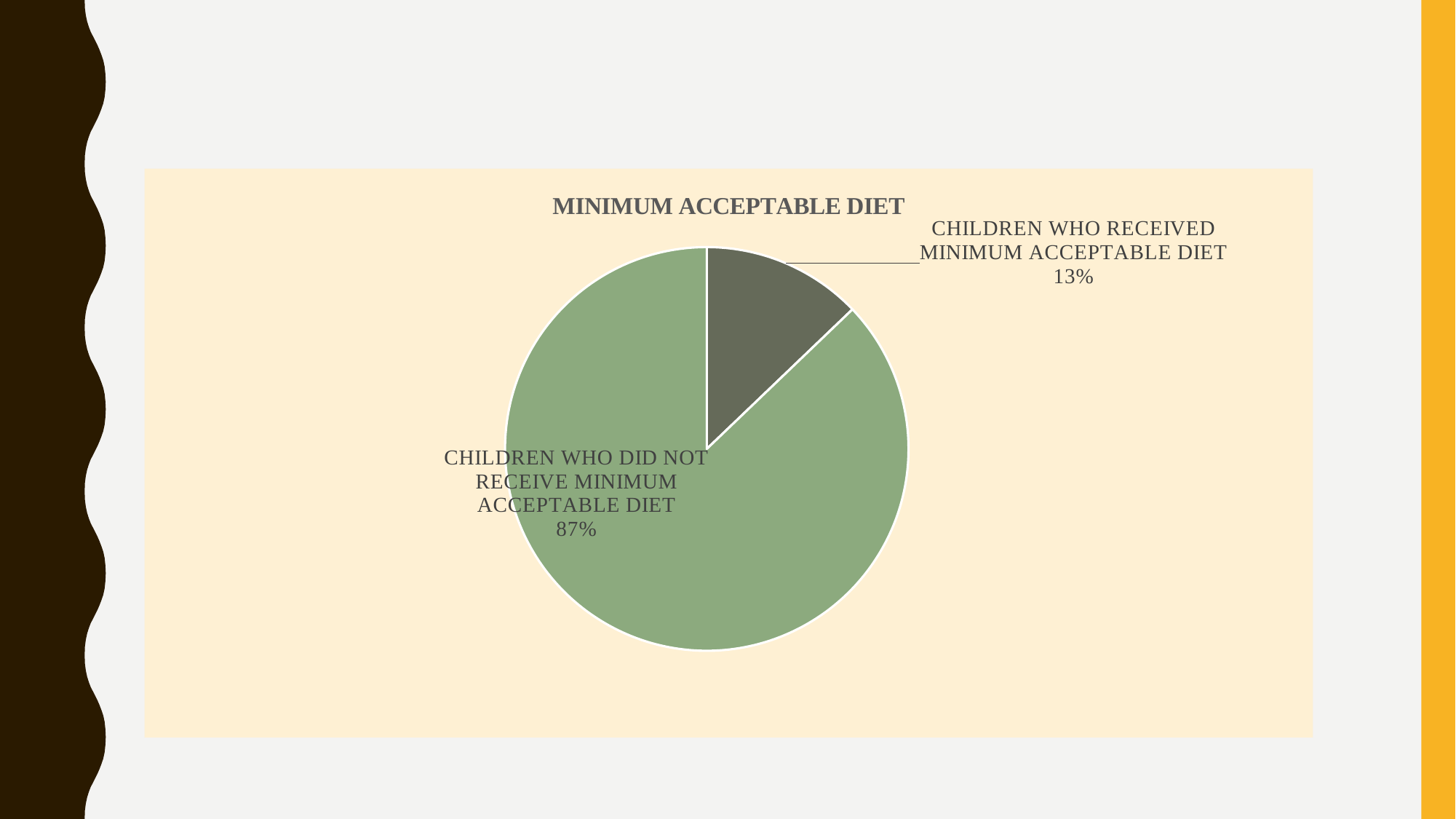
Which slice of the pie is the largest? CHILDREN WHO DID NOT RECEIVE MINIMUM ACCEPTABLE DIET What is the difference in percentage points between children who did not receive and children who received the minimum acceptable diet? 74 What share of the pie does the slice for children who received the minimum acceptable diet represent? 13% Which slice of the pie is the smallest? CHILDREN WHO RECEIVED MINIMUM ACCEPTABLE DIET What percentage of children did not receive the minimum acceptable diet? 87% What percentage of children received the minimum acceptable diet? 13% What is the title of the chart? MINIMUM ACCEPTABLE DIET How many slices does the pie chart have? 2 What colour is the slice for children who did not receive the minimum acceptable diet? Green What kind of chart is shown on the slide? Pie chart Which is larger: the share of children who received the minimum acceptable diet or the share who did not? Children who did not receive minimum acceptable diet